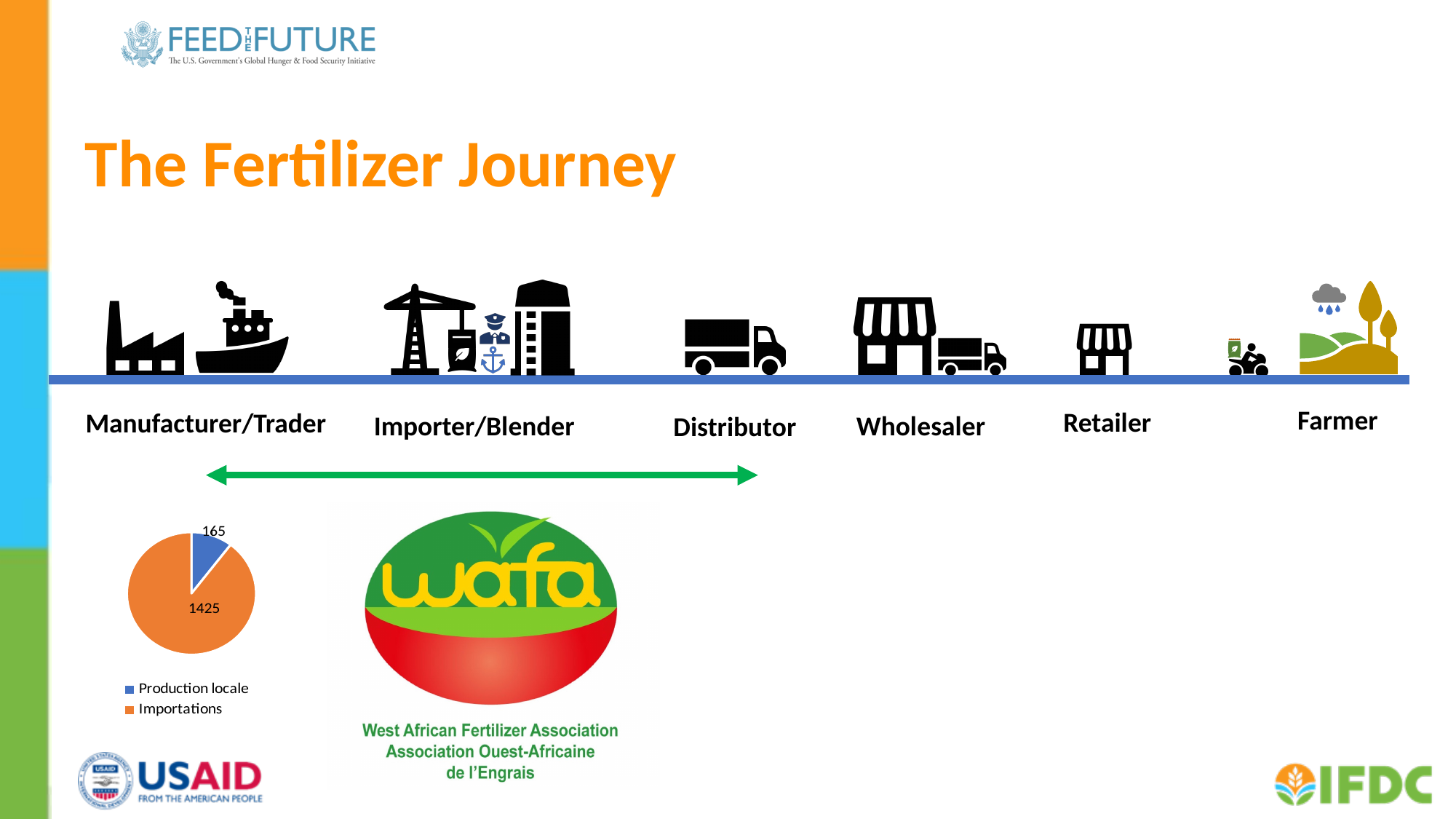
In the pie chart, what is the value for Production locale? 165 Which slice of the pie chart is the largest? Importations What colour is the Production locale slice in the pie chart? blue In the pie chart, which is larger: Production locale or Importations? Importations Which slice of the pie chart is the smallest? Production locale What kind of chart is shown at the bottom left of the slide? pie chart How many slices does the pie chart have? 2 How many entries does the pie chart's legend list? 2 What is the difference between the Importations value and the Production locale value in the pie chart? 1260 In the pie chart, what is the value for Importations? 1425 What is the total of the two values shown in the pie chart? 1590 What colour is the Importations slice in the pie chart? orange